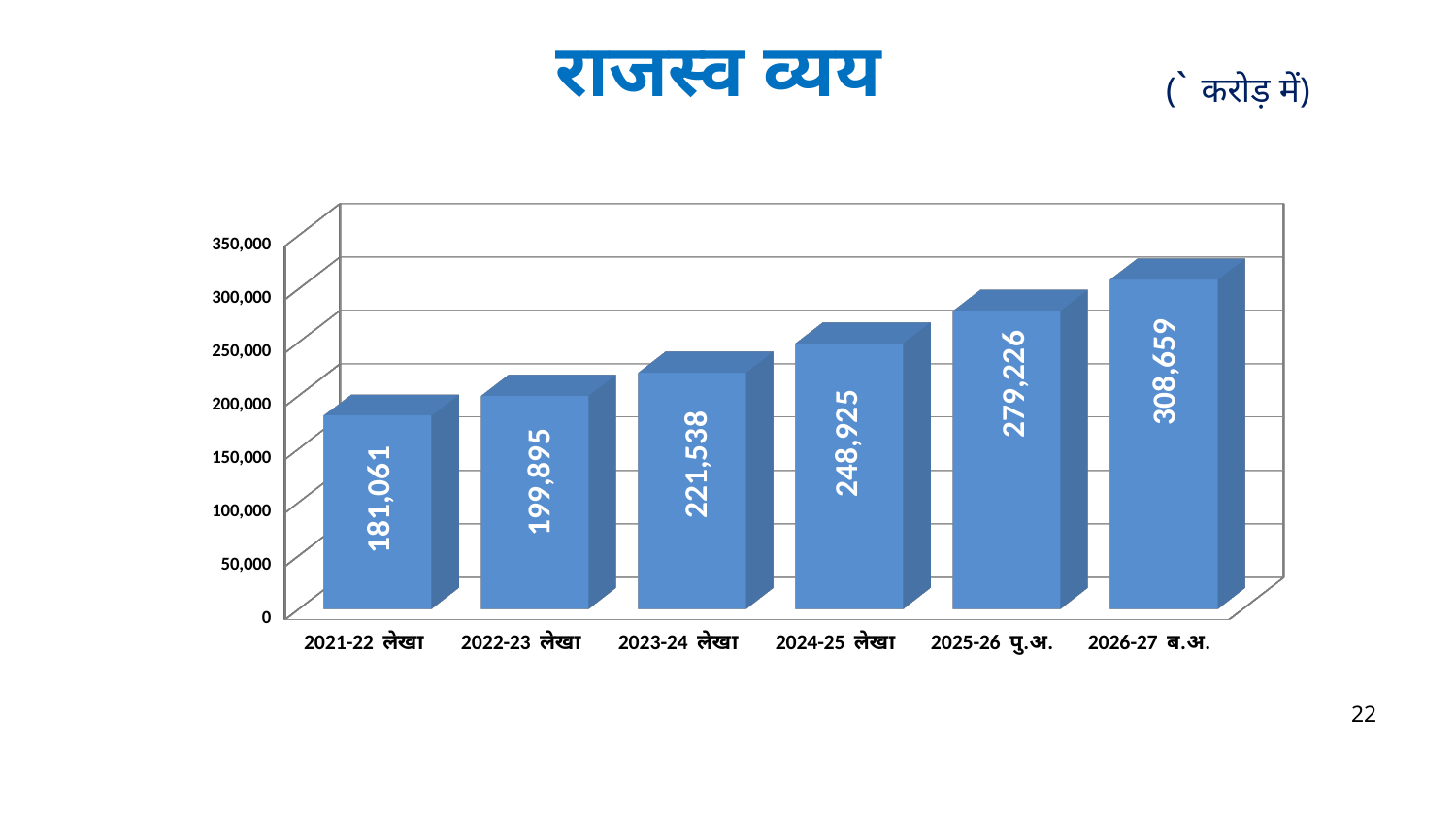
What is the value for 2021-22 लेखा? 181,061 What is the value for 2024-25 लेखा? 248,925 What is the difference between the values for 2024-25 लेखा and 2023-24 लेखा? 27,387 Is the value for 2025-26 पु.अ. greater or less than 250,000? greater What is the difference between the values for 2026-27 ब.अ. and 2025-26 पु.अ.? 29,433 How many categories are shown on the x axis? 6 Do the values rise or fall from 2021-22 लेखा to 2026-27 ब.अ.? rise What kind of chart is shown on the slide? bar chart Which category has the highest value? 2026-27 ब.अ. Which is larger, the value for 2022-23 लेखा or the value for 2023-24 लेखा? 2023-24 लेखा What is the value for 2026-27 ब.अ.? 308,659 Which category has the lowest value? 2021-22 लेखा